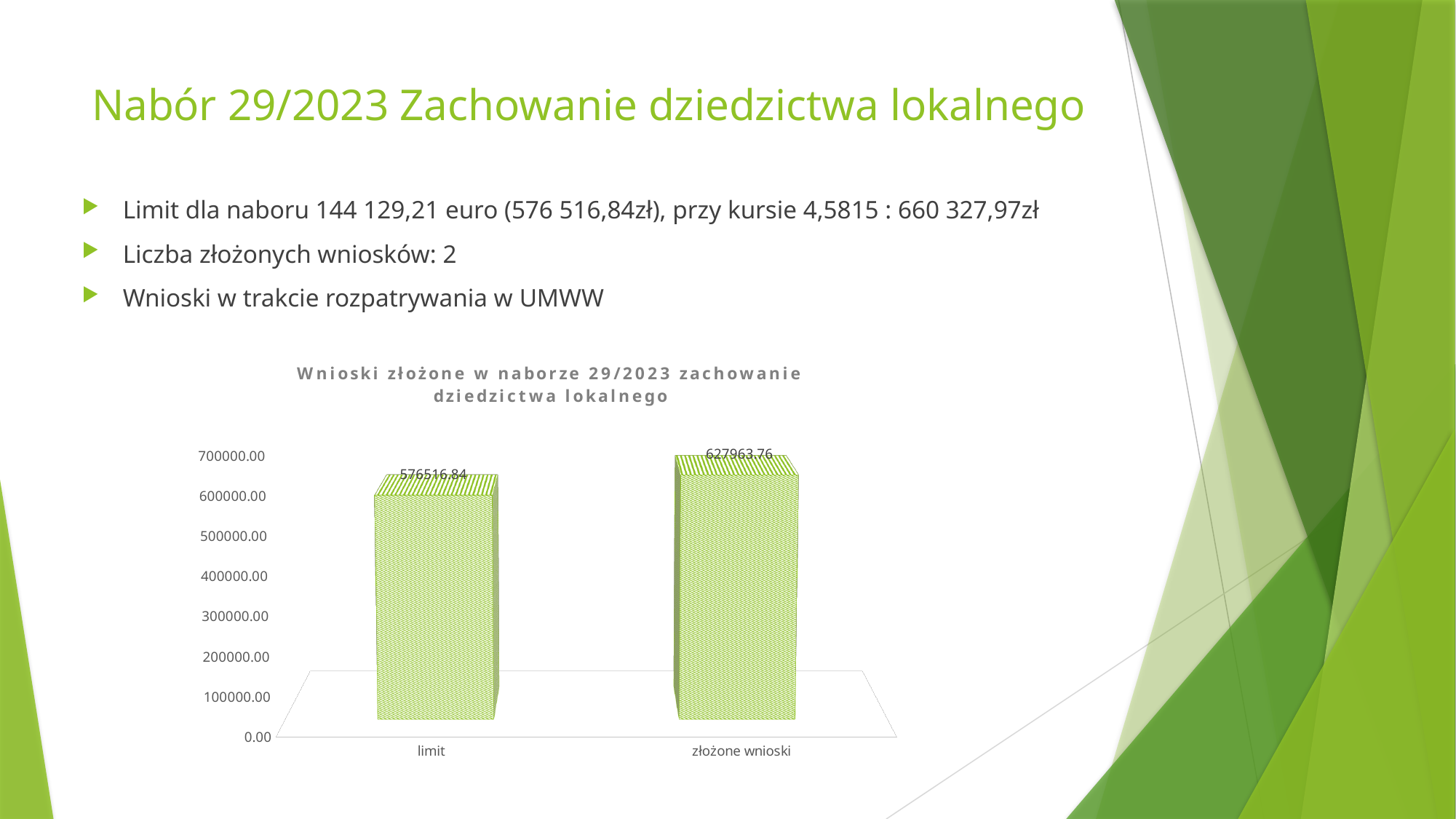
Is the value for "złożone wnioski" greater or less than 600000.00? greater What kind of chart is shown on the slide? bar chart Which is larger: the value for "limit" or the value for "złożone wnioski"? złożone wnioski Which category has the lowest value in the chart? limit What is the value for "złożone wnioski" in the chart? 627963.76 Do the values rise or fall from "limit" to "złożone wnioski"? rise Is the value for "limit" greater or less than 600000.00? less How many categories are shown in the chart? 2 What is the value for "limit" in the chart? 576516.84 What is the difference between the value for "złożone wnioski" and the value for "limit"? 51446.92 Which category has the highest value in the chart? złożone wnioski What is the title of the chart? Wnioski złożone w naborze 29/2023 zachowanie dziedzictwa lokalnego